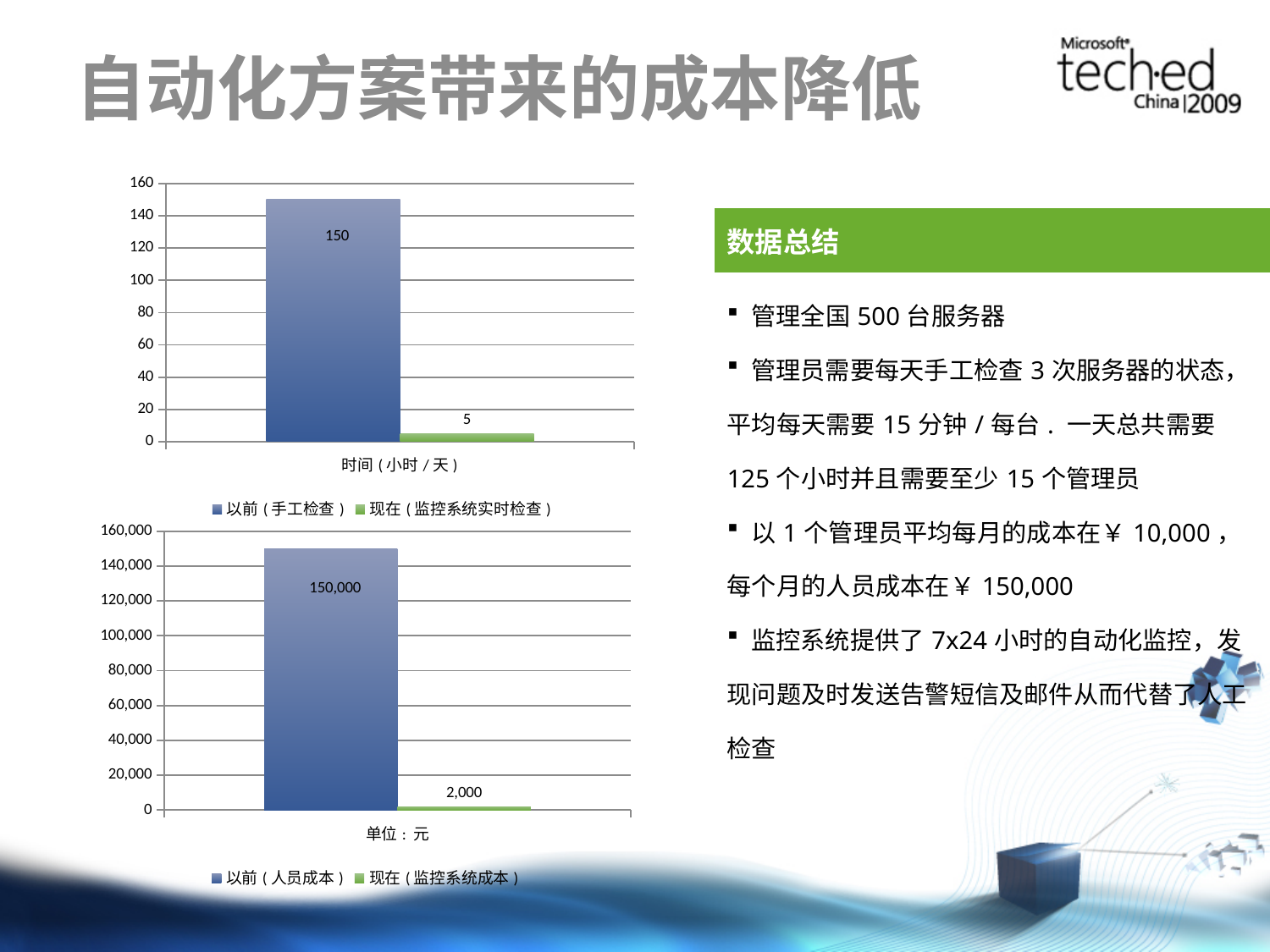
In the top chart (时间（小时/天）), which series has the higher value? 以前（手工检查） What is the axis label shown below the bars of the top chart? 时间（小时/天） In the top chart (时间（小时/天）), what is the difference between 以前（手工检查） and 现在（监控系统实时检查）? 145 In the top chart (时间（小时/天）), what is the value for 以前（手工检查）? 150 In the bottom chart (单位：元), is the value for 以前（人员成本） larger or smaller than the value for 现在（监控系统成本）? larger In the bottom chart (单位：元), which series has the lower value? 现在（监控系统成本） In the bottom chart (单位：元), what is the value for 以前（人员成本）? 150,000 In the bottom chart (单位：元), what is the value for 现在（监控系统成本）? 2,000 What kind of chart is the bottom chart (单位：元)? bar chart How many series does the legend of the top chart (时间（小时/天）) list? 2 In the bottom chart (单位：元), what is the difference between 以前（人员成本） and 现在（监控系统成本）? 148,000 In the top chart (时间（小时/天）), what is the value for 现在（监控系统实时检查）? 5